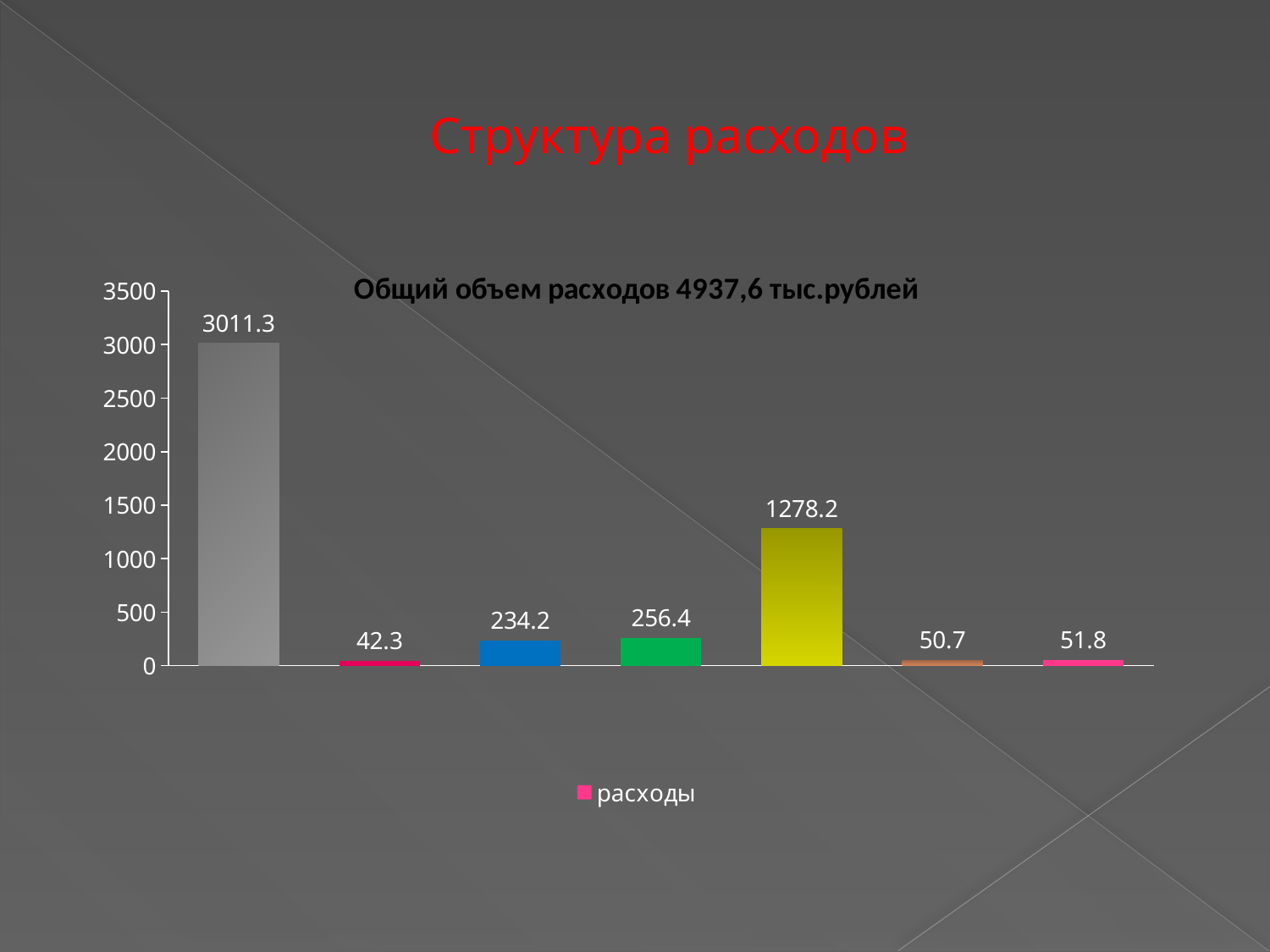
Which bar has the lowest value? the second bar (42.3) Which is larger, the green bar or the blue bar? the green bar What type of chart is shown on the slide? bar chart What is the difference between the first bar (3011.3) and the yellow bar (1278.2)? 1733.1 What is the value shown on the green bar? 256.4 How many bars are plotted in the chart? 7 How many series does the legend list? 1 What is the value shown on the yellow bar? 1278.2 What is the value shown on the last (pink) bar on the right? 51.8 What is the value shown on the first (grey) bar from the left? 3011.3 What is the chart's title? Общий объем расходов 4937,6 тыс.рублей What is the value shown on the blue bar? 234.2